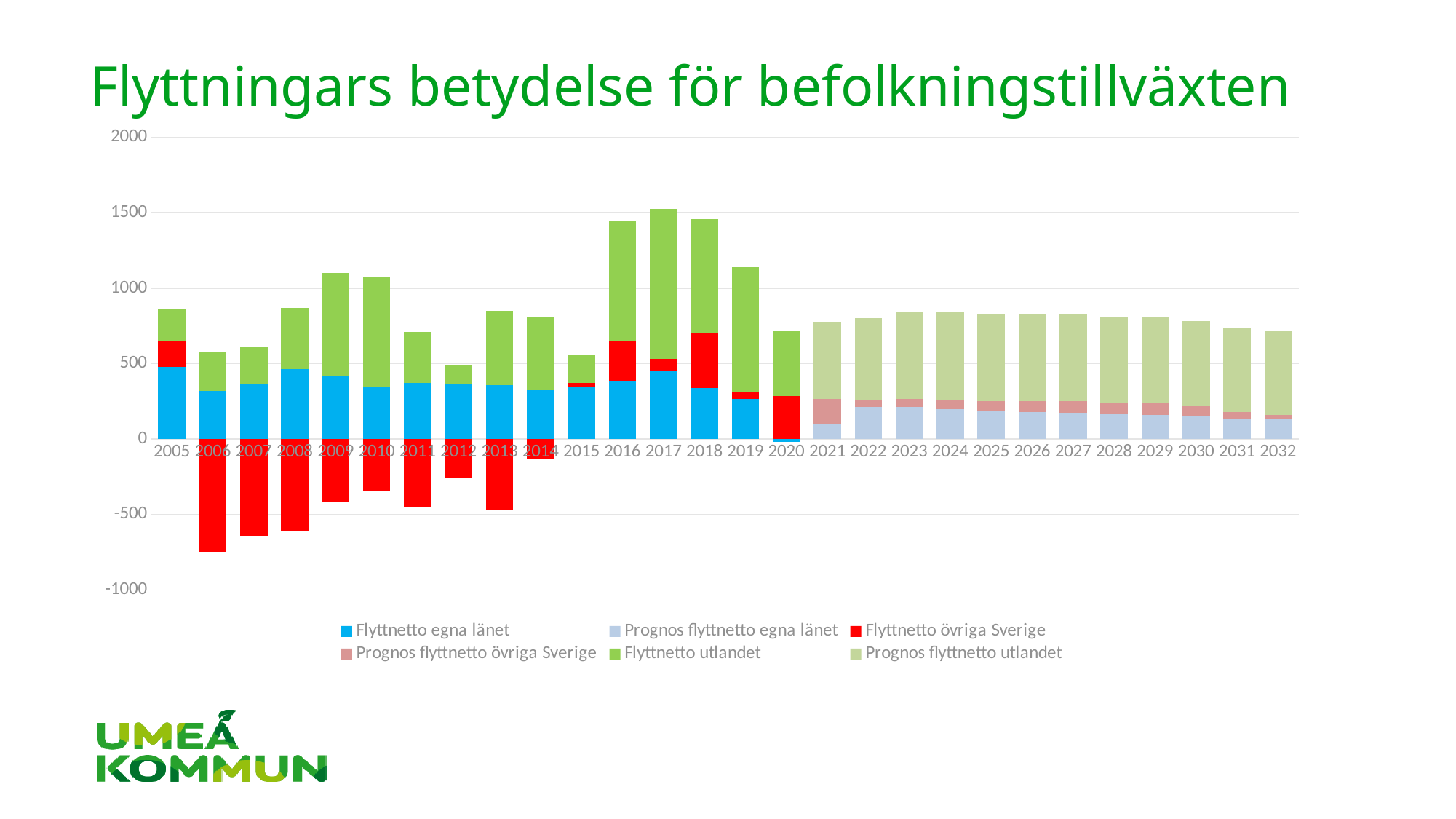
Is the total height of the stacked bar for 2017 greater or less than 1000? greater Is the value for Flyttnetto egna länet in 2012 greater or less than 500? less Which series is drawn in red in the chart? Flyttnetto övriga Sverige Which year has the tallest positive stacked bar? 2017 How many years are shown on the x axis of the chart? 28 What kind of chart is shown on the slide? bar chart How many series does the legend list? 6 What is the title of the slide's chart? Flyttningars betydelse för befolkningstillväxten Do the forecast (prognos) stacked bar totals rise or fall from 2023 to 2032? fall Which year has the lowest (most negative) value for Flyttnetto övriga Sverige? 2006 Which year has the larger Flyttnetto utlandet segment, 2015 or 2016? 2016 Is the value for Flyttnetto övriga Sverige in 2006 greater or less than -500? less